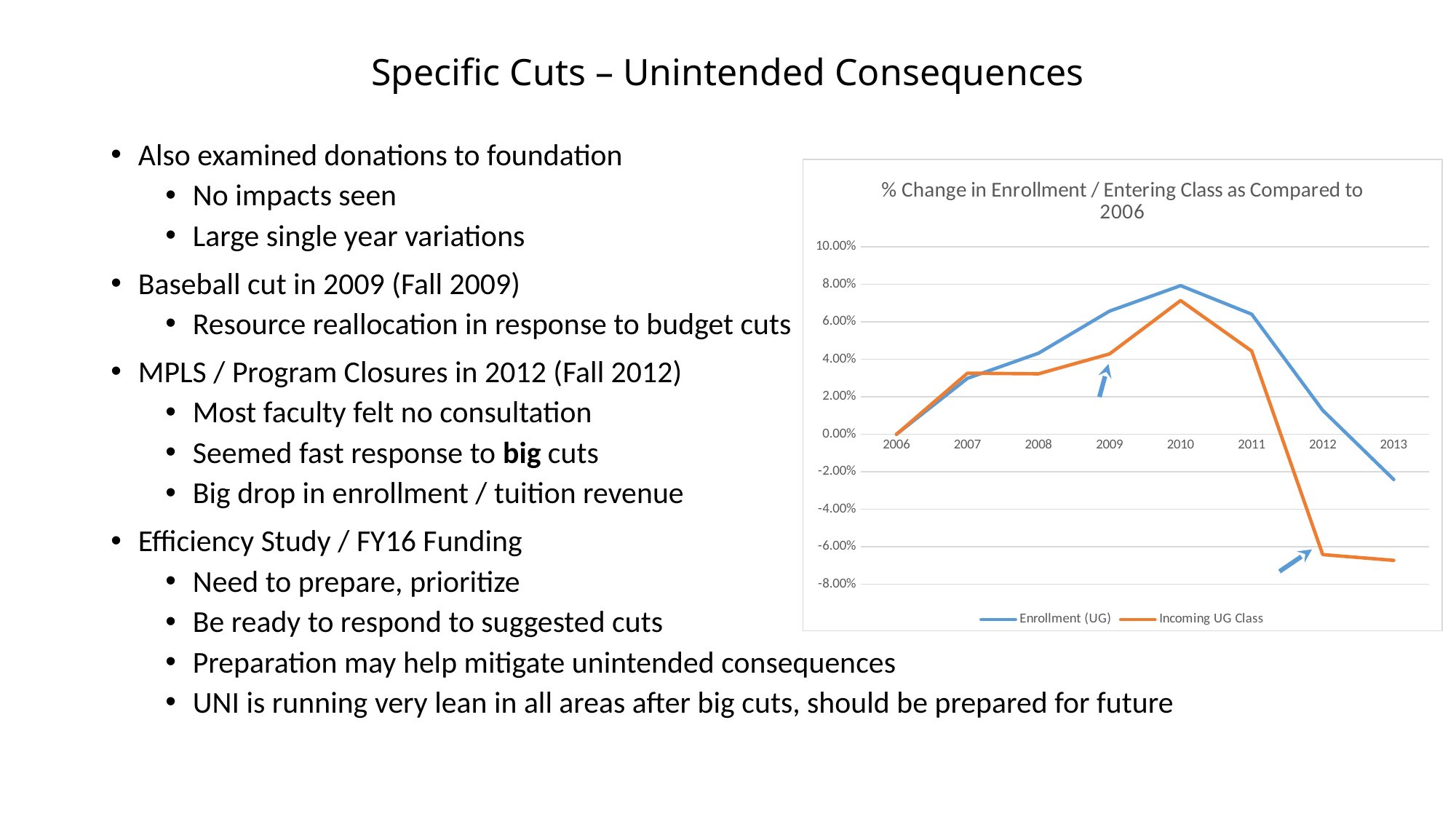
In which year does the Enrollment (UG) series reach its highest value? 2010 What is the title of the chart? % Change in Enrollment / Entering Class as Compared to 2006 Is the value for Incoming UG Class in 2012 greater or less than -4.00%? less What kind of chart is shown on the slide? line chart How many series does the chart legend list? 2 In 2013, which series has the higher value, Enrollment (UG) or Incoming UG Class? Enrollment (UG) In which year does the Incoming UG Class series reach its highest value? 2010 What is the value of Enrollment (UG) in 2006? 0.00% Does the Enrollment (UG) series rise or fall from 2010 to 2013? fall Is the value for Enrollment (UG) in 2010 greater or less than 6.00%? greater How many years are plotted along the x axis of the chart? 8 In which year is the Enrollment (UG) series at its lowest value? 2013